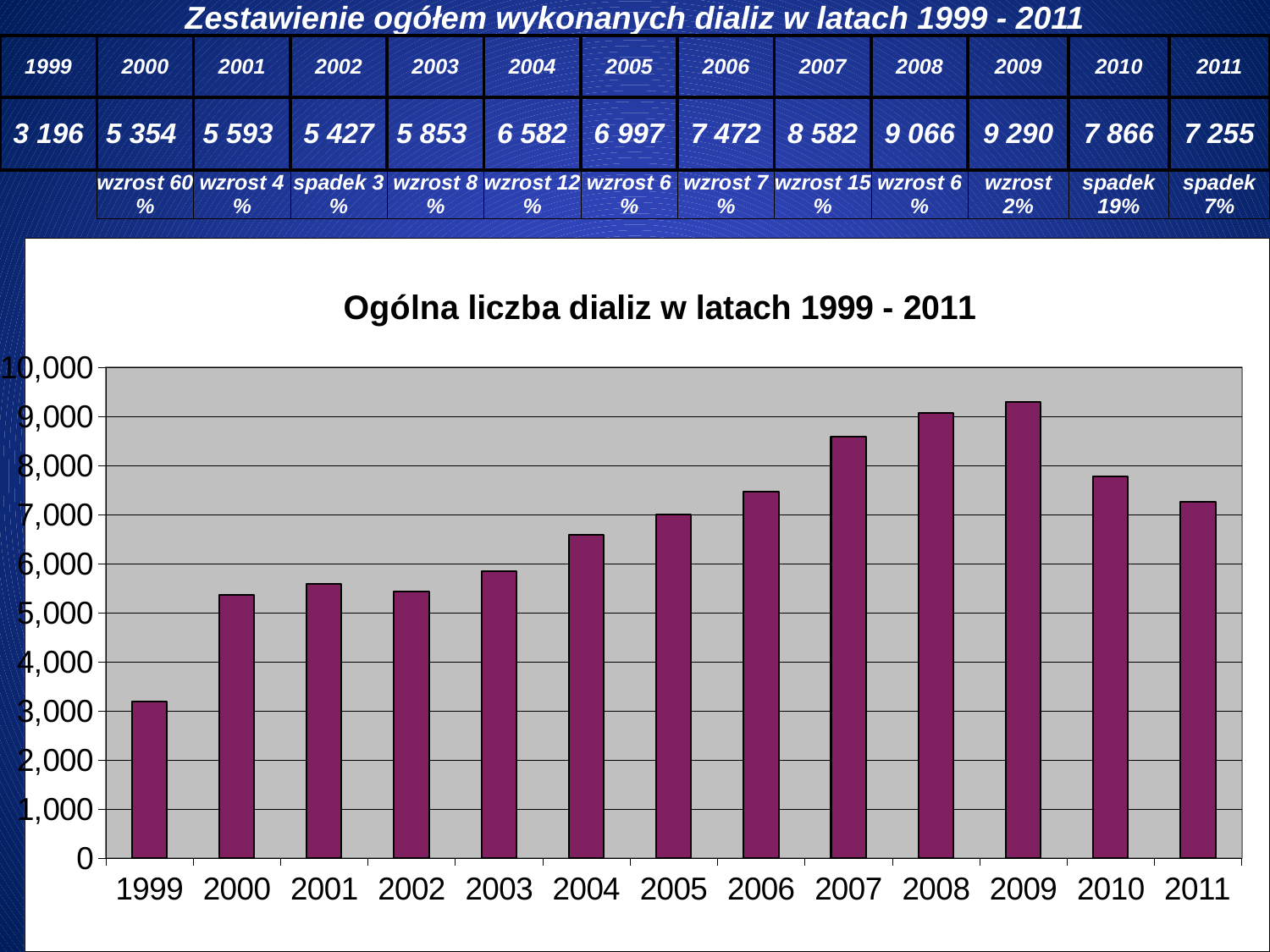
According to the table on the slide, how many dialyses were performed in 2009? 9 290 Is the value for 2002 in the chart greater or less than 6,000? less What kind of chart is shown on the slide? bar chart Is the value for 2007 in the chart greater or less than 8,000? greater Do the values in the chart rise or fall from 2009 to 2011? fall Which is larger in the chart, the value for 2010 or the value for 2011? 2010 Which year has the lowest bar in the chart? 1999 What is the title of the chart? Ogólna liczba dializ w latach 1999 - 2011 Which is larger in the chart, the value for 2001 or the value for 2002? 2001 Is the value for 2011 in the chart greater or less than 7,000? greater Which year has the highest bar in the chart? 2009 How many years (bars) are plotted in the chart? 13